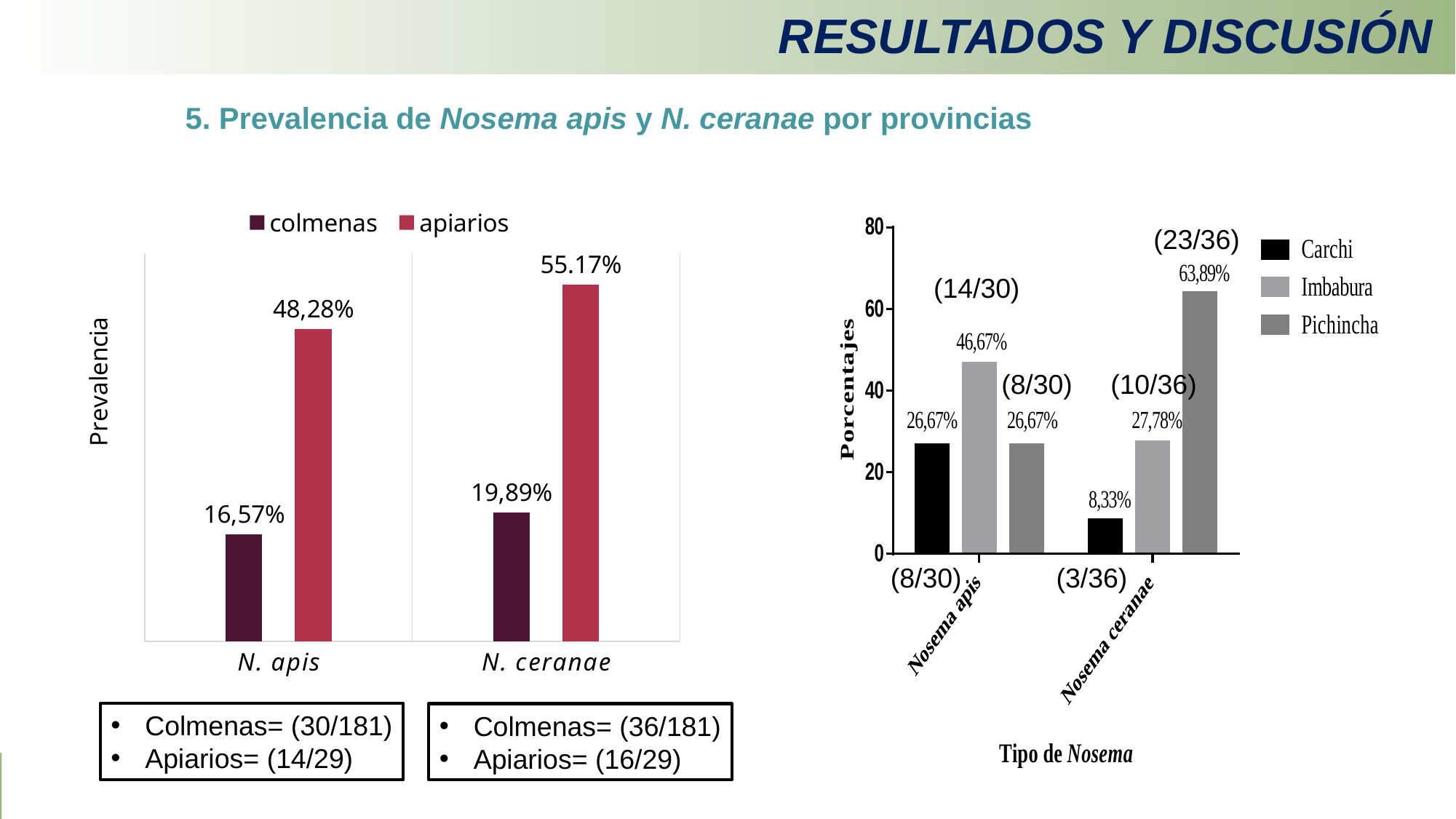
In the right chart (Porcentajes), what is the value for Pichincha for Nosema ceranae? 63,89% In the left chart (Prevalencia), what is the value for apiarios for N. apis? 48,28% In the right chart (Porcentajes), what is the difference between the Pichincha and Carchi values for Nosema ceranae? 55,56% In the left chart (Prevalencia), which series has the higher value for N. ceranae, colmenas or apiarios? apiarios In the left chart (Prevalencia), what is the value for colmenas for N. ceranae? 19,89% In the right chart (Porcentajes), which province has the highest value for Nosema apis? Imbabura In the right chart (Porcentajes), how many series does the legend list? 3 In the right chart (Porcentajes), which province has the lowest value for Nosema ceranae? Carchi What kind of chart is the right chart (Porcentajes)? bar chart In the left chart (Prevalencia), what is the difference between the apiarios and colmenas values for N. apis? 31,71% In the left chart (Prevalencia), how many series does the legend list? 2 In the right chart (Porcentajes), what is the value for Imbabura for Nosema apis? 46,67%